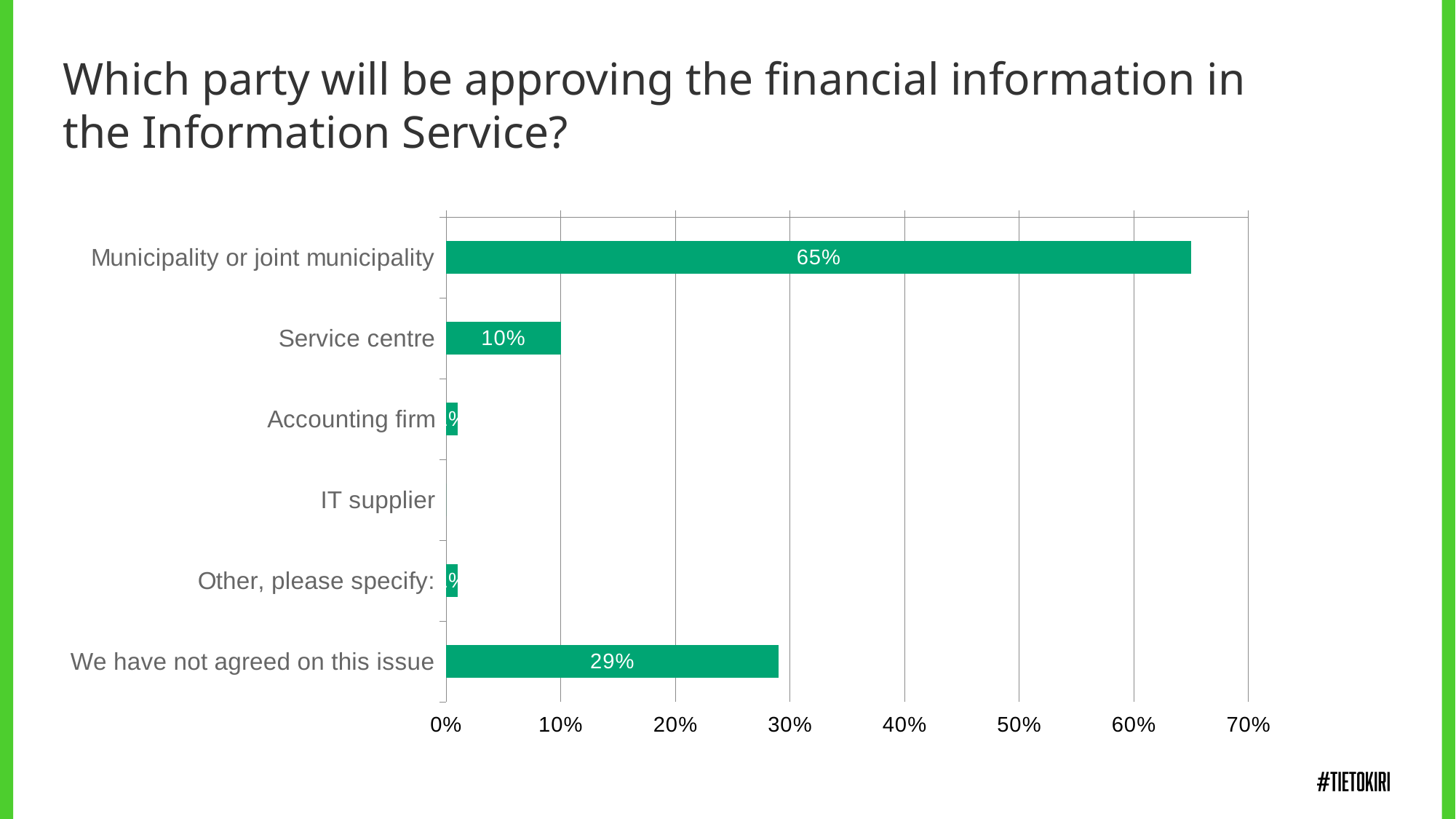
What kind of chart is shown on the slide? bar chart Which category has the highest value? Municipality or joint municipality What is the difference between the values for Municipality or joint municipality and We have not agreed on this issue? 36 percentage points Which is larger, the value for Service centre or the value for We have not agreed on this issue? We have not agreed on this issue How many categories are shown in the chart? 6 What is the value for We have not agreed on this issue? 29% Which category has the lowest value? IT supplier What is the value for Municipality or joint municipality? 65% What is the title of the slide containing the chart? Which party will be approving the financial information in the Information Service? What is the difference between the values for We have not agreed on this issue and Service centre? 19 percentage points Is the value for Accounting firm greater or less than 10%? less What is the value for Service centre? 10%